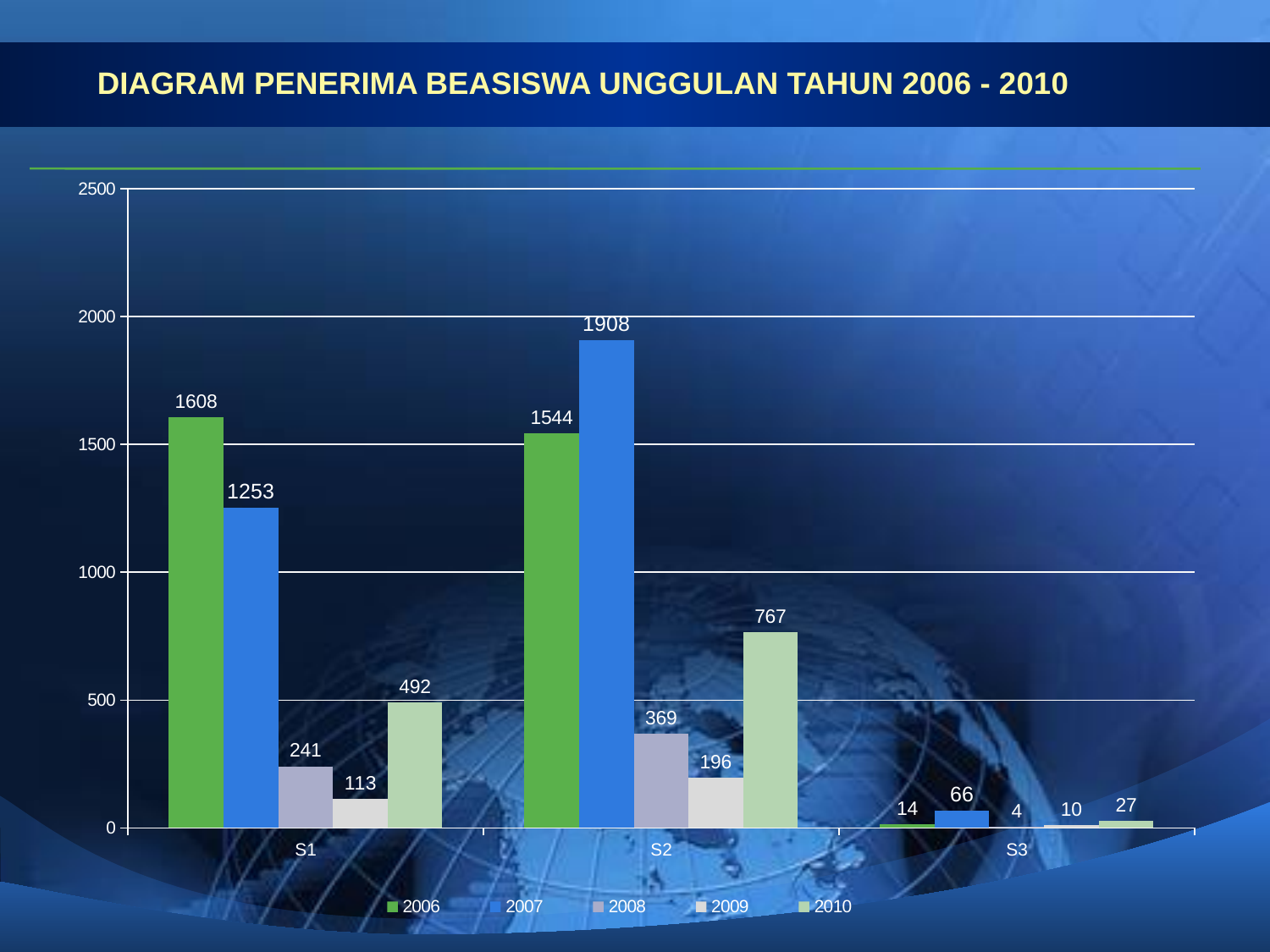
How many series does the legend list? 5 Which is larger in the S1 category: the 2008 value or the 2010 value? 2010 Is the value for 2007 in S1 greater or less than 1000? greater How many categories are shown on the x axis? 3 Which category has the highest value for the 2010 series? S2 What is the title of the chart? DIAGRAM PENERIMA BEASISWA UNGGULAN TAHUN 2006 - 2010 What is the value for 2006 in the S1 category? 1608 Which series has the lowest value in the S3 category? 2008 What is the difference between the 2007 and 2006 values in the S2 category? 364 What is the value for 2007 in the S2 category? 1908 What is the value for 2009 in the S3 category? 10 What kind of chart is shown on the slide? bar chart